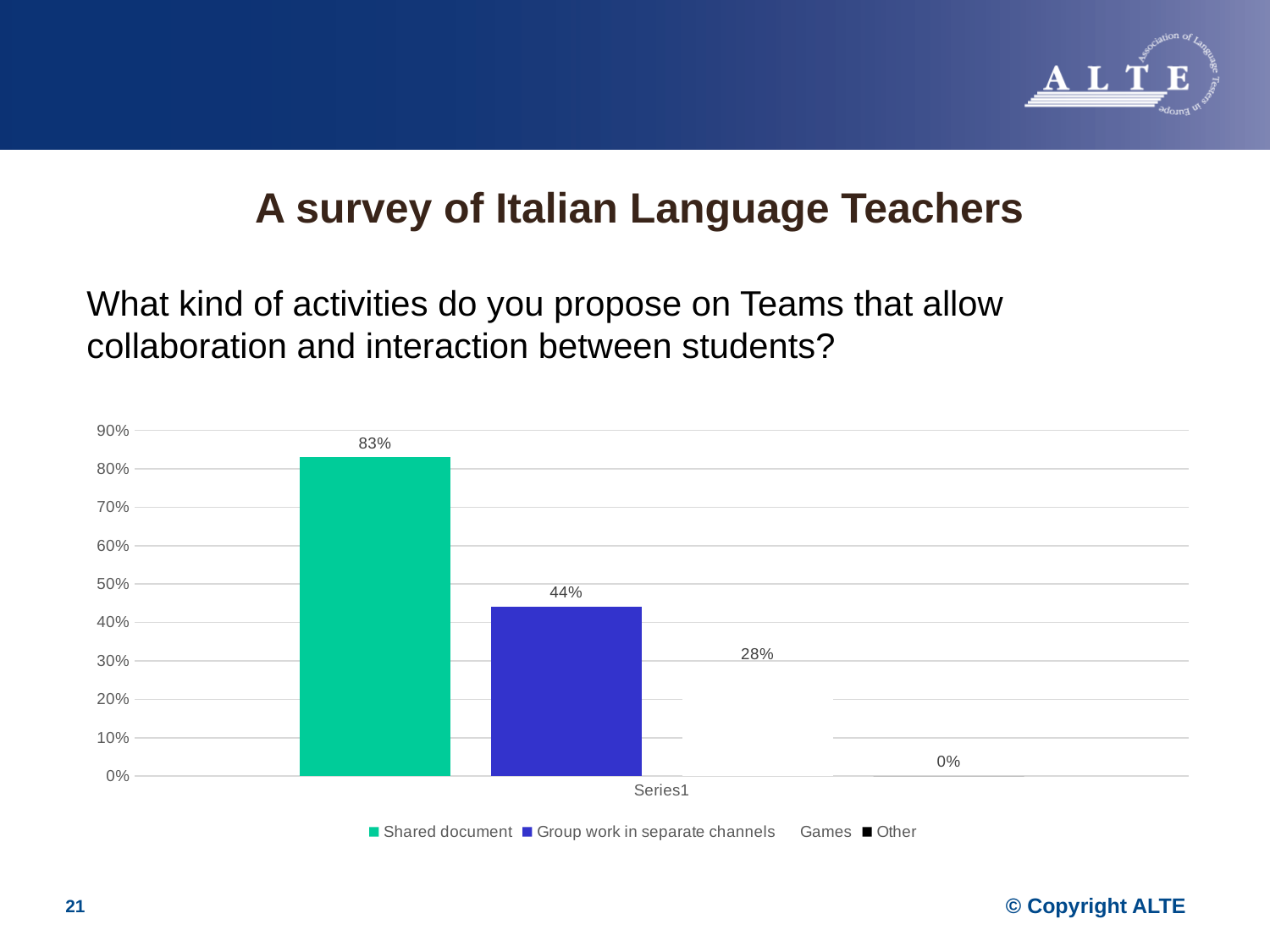
What is the value for Other? 0% What kind of chart is shown on the slide? bar chart Which series has the highest value? Shared document What is the value for Shared document? 83% Is the value for Shared document greater or less than 80%? greater Which is larger, the value for Group work in separate channels or the value for Games? Group work in separate channels What is the difference between the values for Shared document and Group work in separate channels? 39% Which series has the lowest value? Other What colour is the bar for Shared document? green How many series does the legend list? 4 What is the value for Games? 28% What is the value for Group work in separate channels? 44%